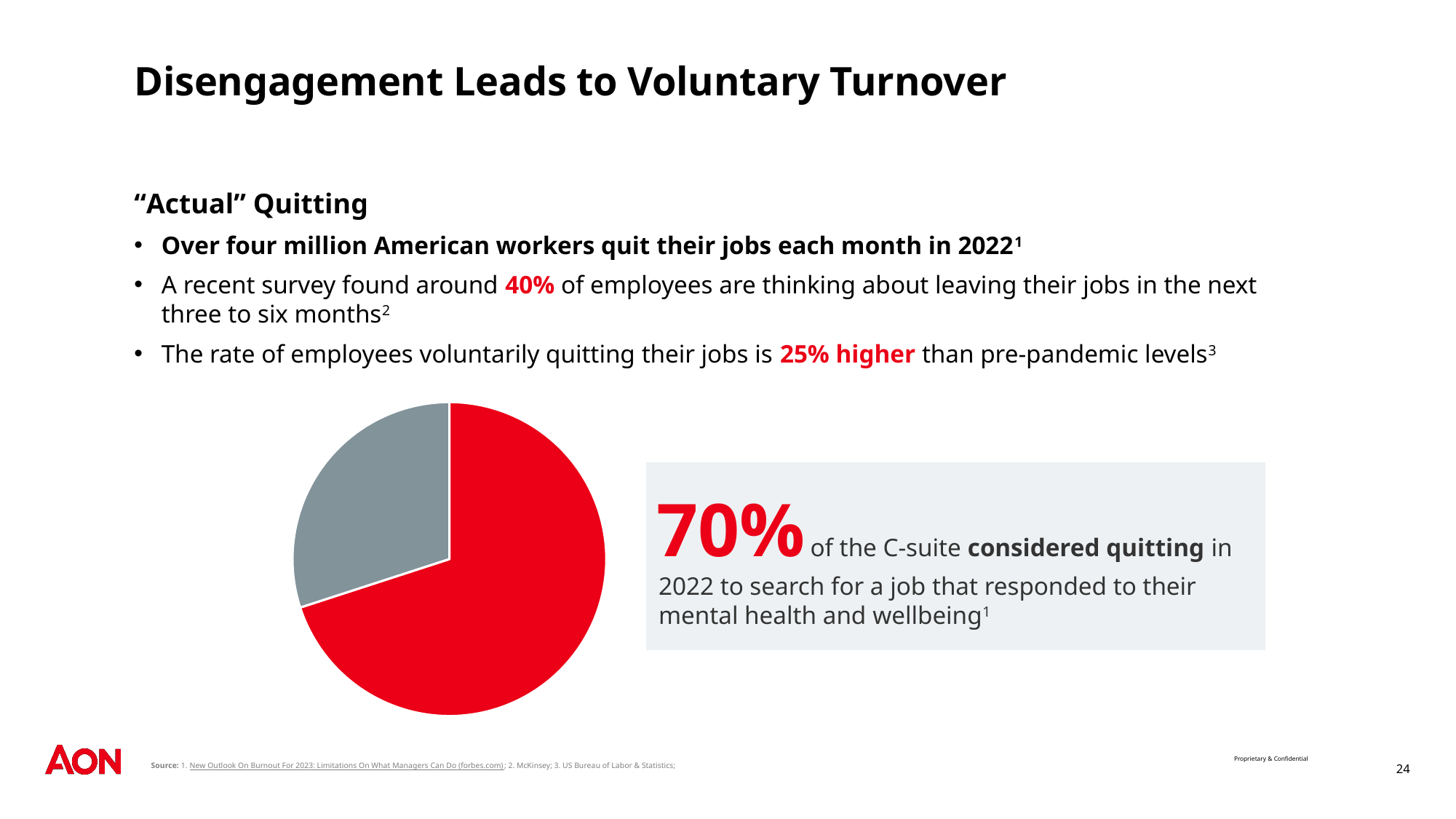
What kind of chart is shown on the slide? pie chart Which slice of the pie chart is larger, the red one or the grey one? red What share of the pie does the red slice represent? 70% Which slice of the pie chart is the smallest? grey Does the pie chart have a legend? no What percentage of the C-suite considered quitting in 2022, according to the callout next to the pie chart? 70% What colour is the largest slice of the pie chart? red How many slices does the pie chart have? 2